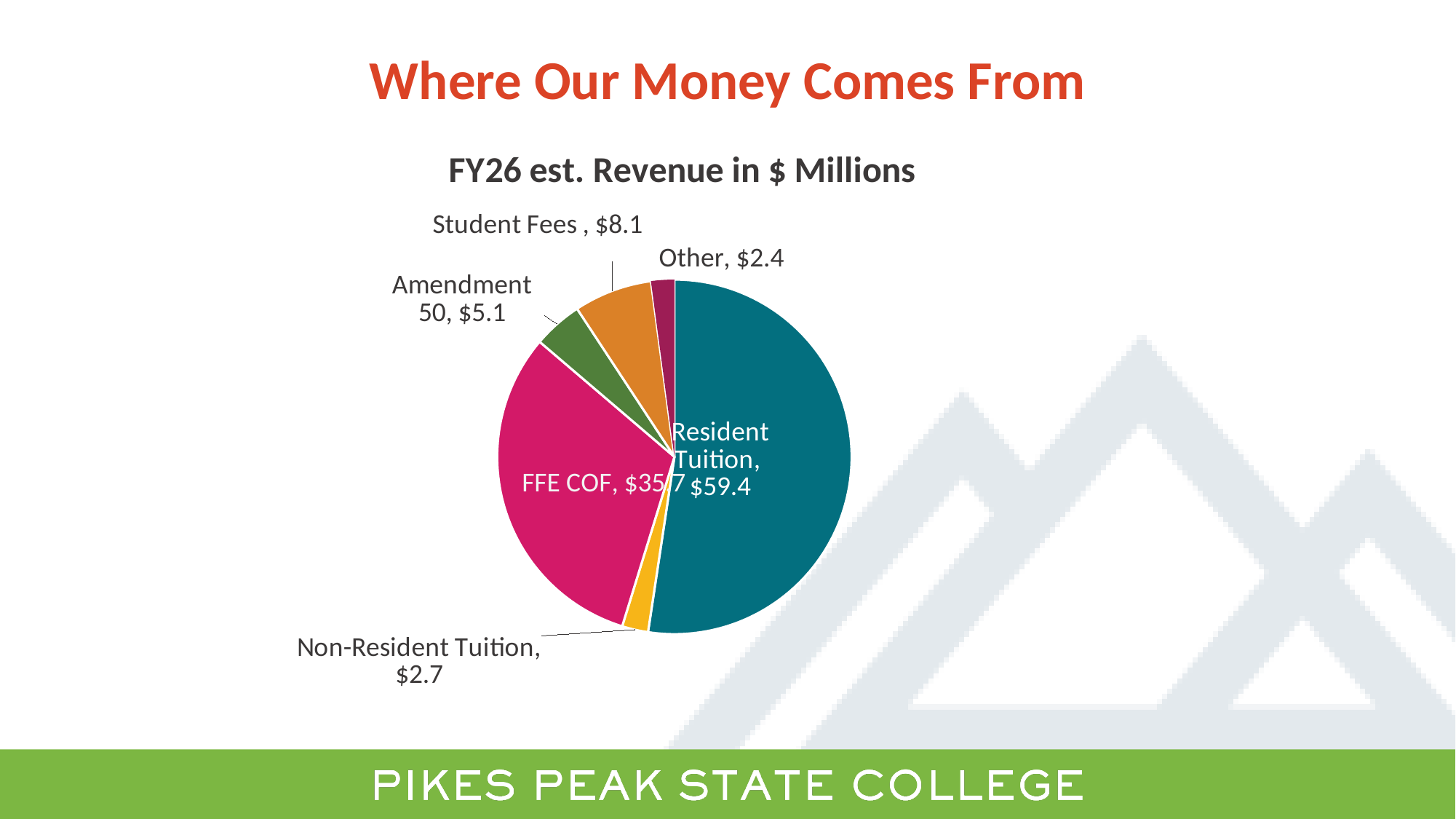
What is the value for Amendment 50? $5.1 What is the difference between Resident Tuition and FFE COF? $23.7 What kind of chart is shown on the slide? Pie chart How many categories are shown in the pie chart? 6 What is the value for FFE COF? $35.7 Which category has the lowest value? Other Which category has the highest value? Resident Tuition What is the total of all slices in the pie chart? $113.4 What is the title of the chart? FY26 est. Revenue in $ Millions Which is larger, Non-Resident Tuition or Other? Non-Resident Tuition What is the value for Student Fees? $8.1 What is the value for Resident Tuition? $59.4